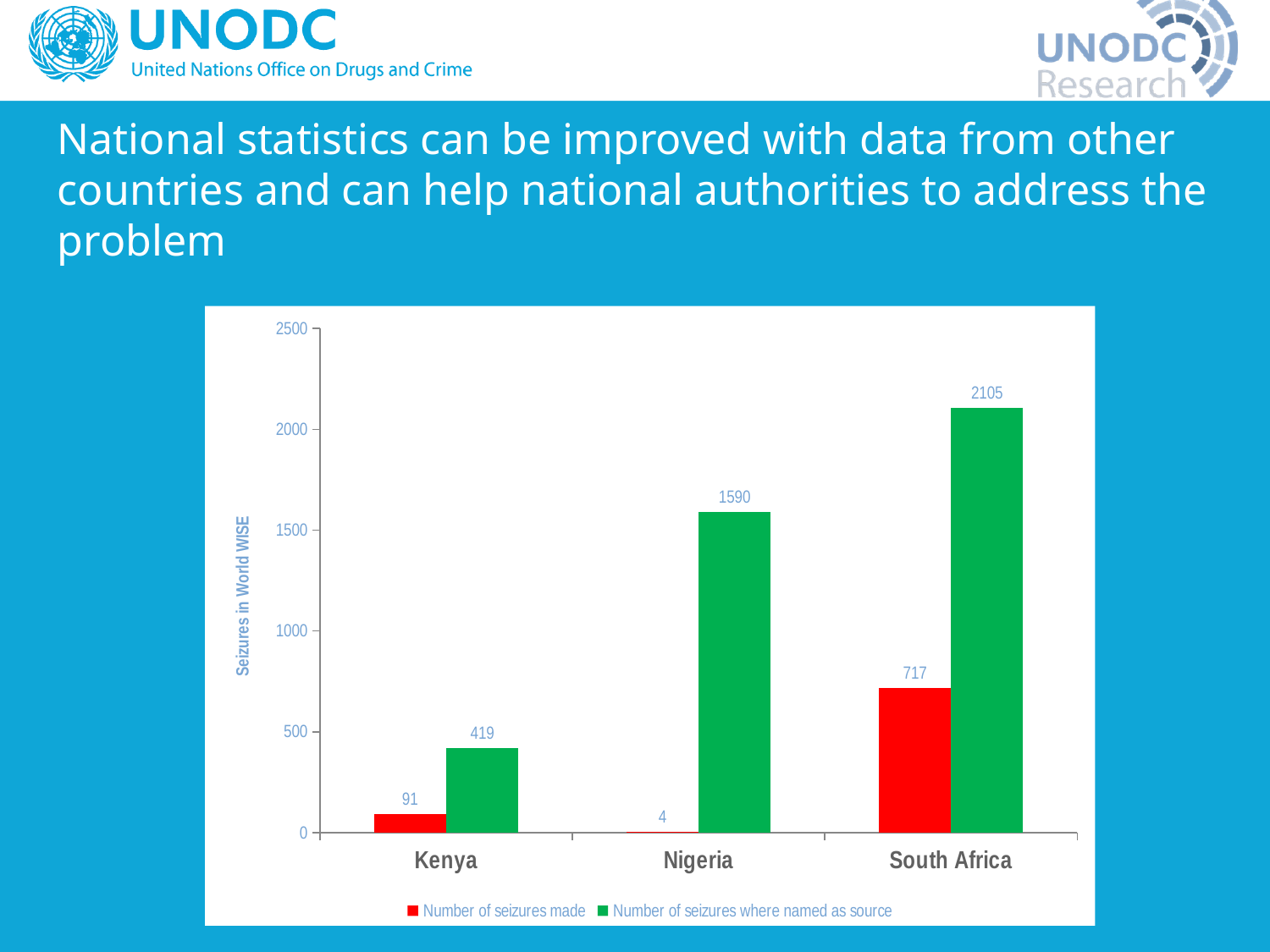
Which is larger for Nigeria: the number of seizures made or the number of seizures where named as source? Number of seizures where named as source What is the label of the vertical axis? Seizures in World WISE What is the number of seizures made for Kenya? 91 What kind of chart is shown on the slide? Bar chart How many series does the legend list? 2 Which country has the highest number of seizures where named as source? South Africa What is the number of seizures where named as source for Nigeria? 1590 What is the difference between the number of seizures where named as source and the number of seizures made for South Africa? 1388 What is the number of seizures where named as source for Kenya? 419 What is the number of seizures made for South Africa? 717 Which country has the lowest number of seizures made? Nigeria How many countries are shown on the x axis? 3